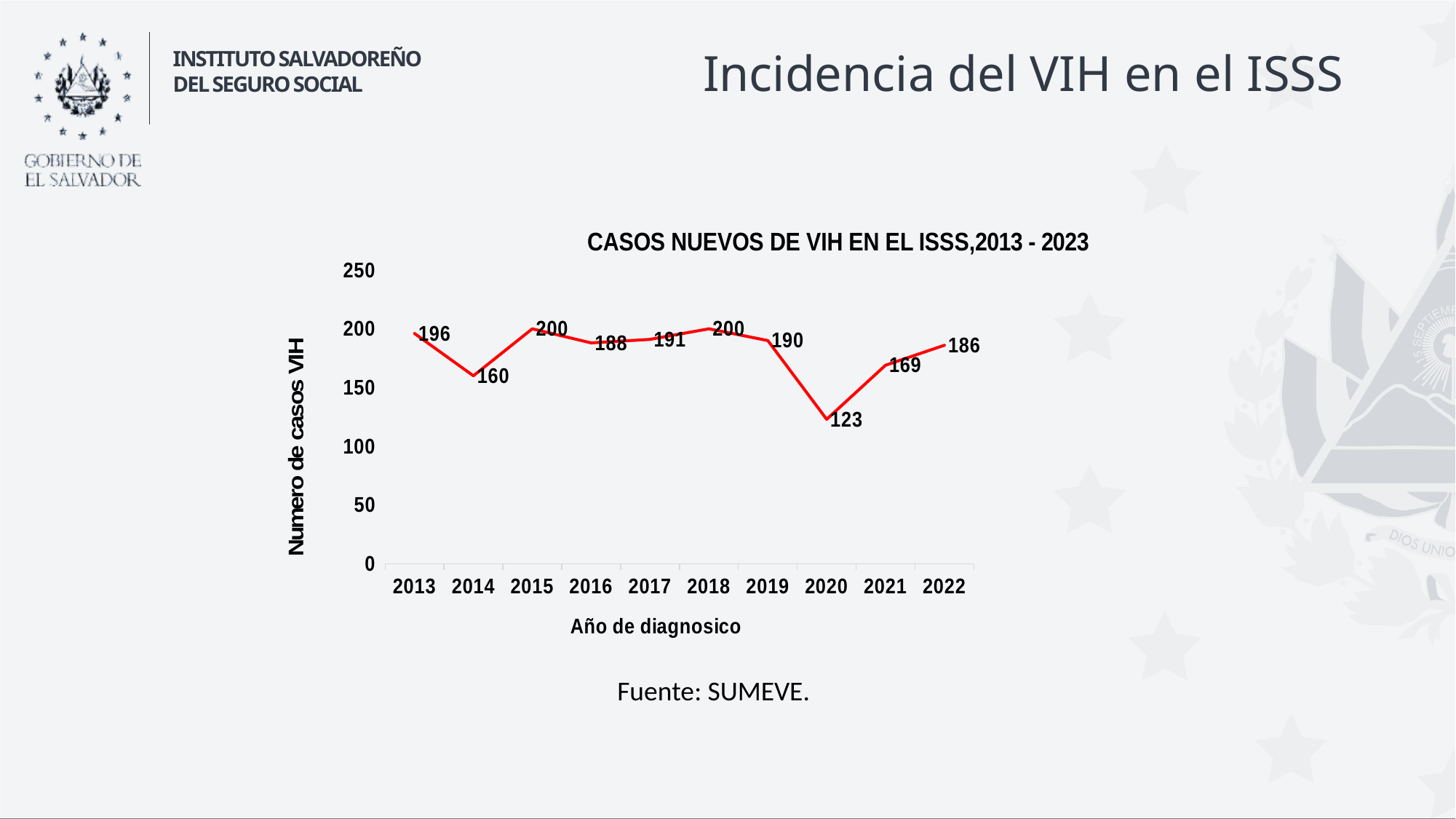
Is the value for 2014 greater or less than 150? greater What is the title of the chart? CASOS NUEVOS DE VIH EN EL ISSS,2013 - 2023 Do the values rise or fall from 2020 to 2022? Rise How many years are plotted on the x axis? 10 Which is larger, the value for 2016 or the value for 2017? 2017 What kind of chart is shown on the slide? Line chart What is the number of new HIV cases in 2020? 123 What is the number of new HIV cases in 2013? 196 What is the difference between the values for 2019 and 2020? 67 What is the difference between the values for 2013 and 2014? 36 Which year has the lowest number of new HIV cases? 2020 What is the value for 2021? 169